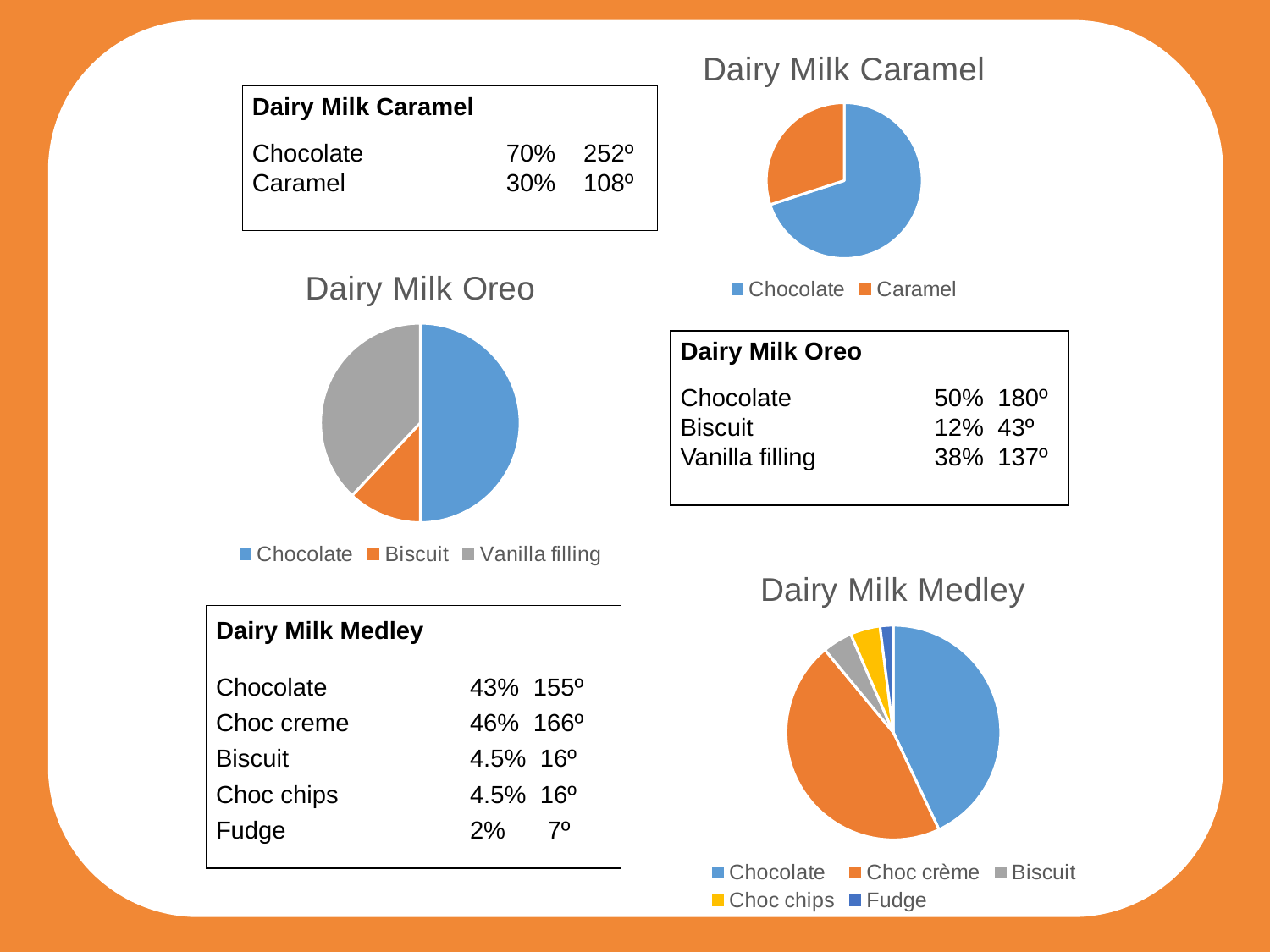
In the "Dairy Milk Caramel" chart, how many degrees does the Caramel slice cover? 108º In the "Dairy Milk Caramel" chart, what percentage share does Chocolate have? 70% In the "Dairy Milk Medley" chart, what percentage share does Fudge have? 2% In the "Dairy Milk Medley" chart, which is larger, Chocolate or Fudge? Chocolate How many slices does the "Dairy Milk Oreo" pie chart have? 3 In the "Dairy Milk Oreo" chart, which ingredient has the smallest slice? Biscuit In the "Dairy Milk Medley" chart, which ingredient has the largest slice? Choc creme In the "Dairy Milk Oreo" chart, what colour is the Vanilla filling slice? grey In the "Dairy Milk Oreo" chart, what percentage share does Vanilla filling have? 38% In the "Dairy Milk Oreo" chart, what is the difference in percentage points between Chocolate and Vanilla filling? 12% What kind of chart is the "Dairy Milk Caramel" chart? pie chart How many entries does the legend of the "Dairy Milk Medley" chart list? 5